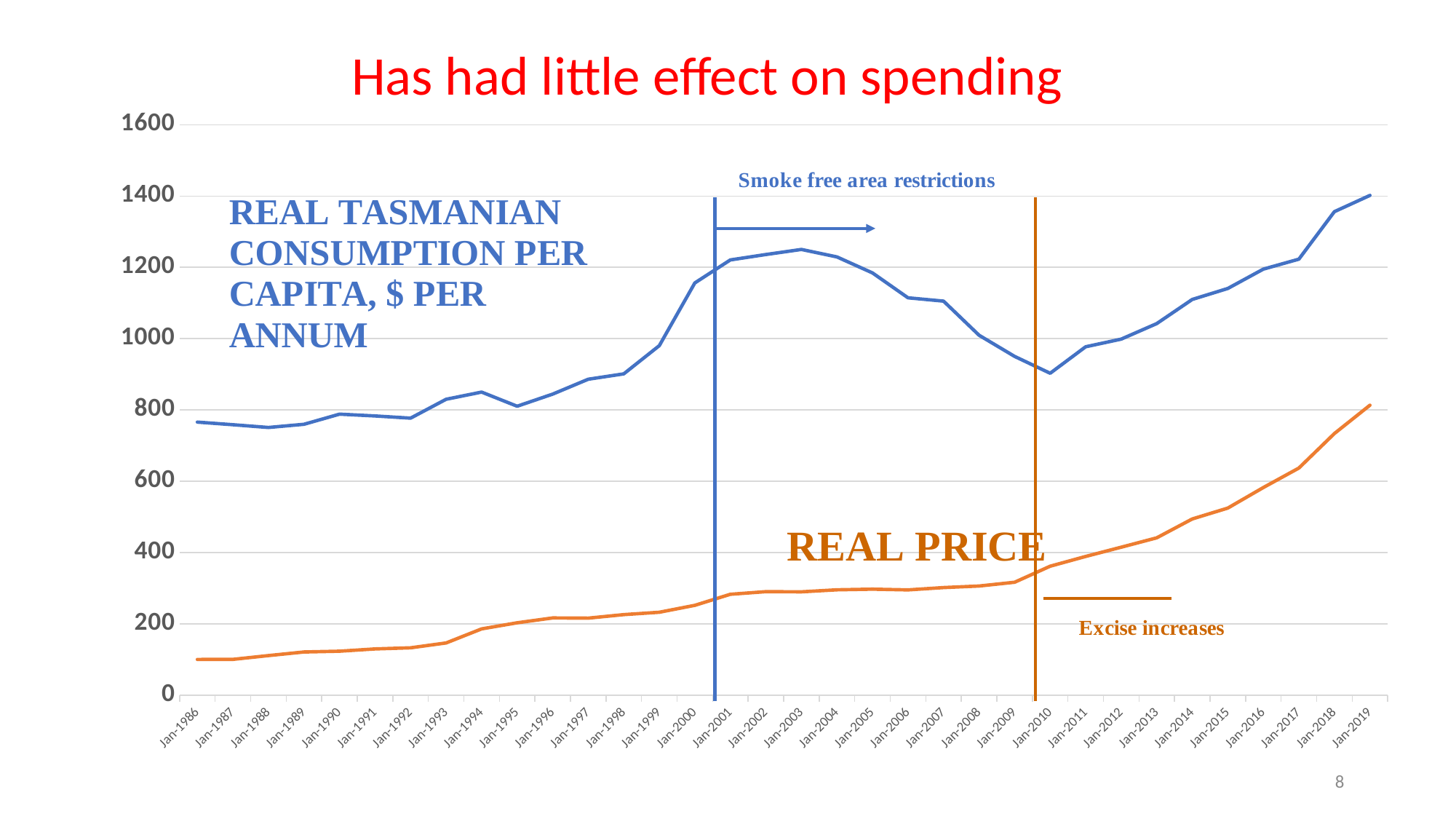
Which series has the higher value at Jan-2005, real Tasmanian consumption per capita or real price? Real Tasmanian consumption per capita How many yearly points are shown along the x axis, from Jan-1986 to Jan-2019? 34 Is the value of real Tasmanian consumption per capita at Jan-2003 greater or less than 1200? greater How many data series (lines) are plotted on the chart? 2 Is the real price value at Jan-2010 greater or less than 400? less What is the title of the slide? Has had little effect on spending Is the value of real Tasmanian consumption per capita at Jan-2010 greater or less than 1000? less What kind of chart is shown on the slide? Line chart At which year does the real Tasmanian consumption per capita line reach its highest value? Jan-2019 Does the real price line generally rise or fall from Jan-1986 to Jan-2019? Rise